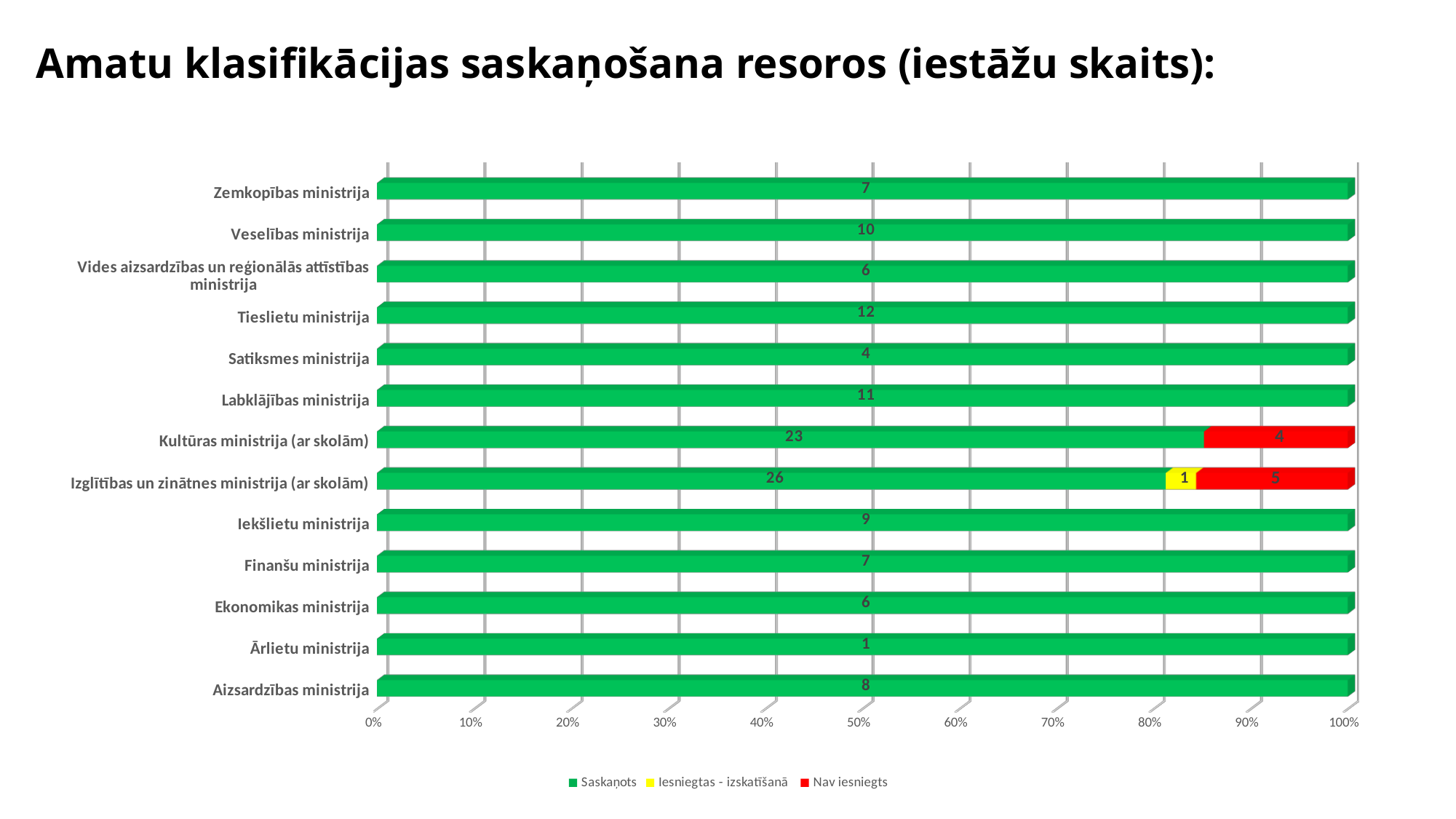
How many ministries are shown on the chart? 13 What is the Nav iesniegts value for Kultūras ministrija (ar skolām)? 4 What kind of chart is shown on the slide? Stacked bar chart Which has a larger Saskaņots value, Veselības ministrija or Labklājības ministrija? Labklājības ministrija What is the difference between the Saskaņots values for Izglītības un zinātnes ministrija (ar skolām) and Kultūras ministrija (ar skolām)? 3 What is the Iesniegtas - izskatīšanā value for Izglītības un zinātnes ministrija (ar skolām)? 1 Which ministry has the lowest Saskaņots value? Ārlietu ministrija What is the total number of institutions for Izglītības un zinātnes ministrija (ar skolām) across all series? 32 What is the Saskaņots value for Tieslietu ministrija? 12 Which ministry has the highest Saskaņots value? Izglītības un zinātnes ministrija (ar skolām) Which colour represents the Nav iesniegts series? Red How many series does the legend list? 3